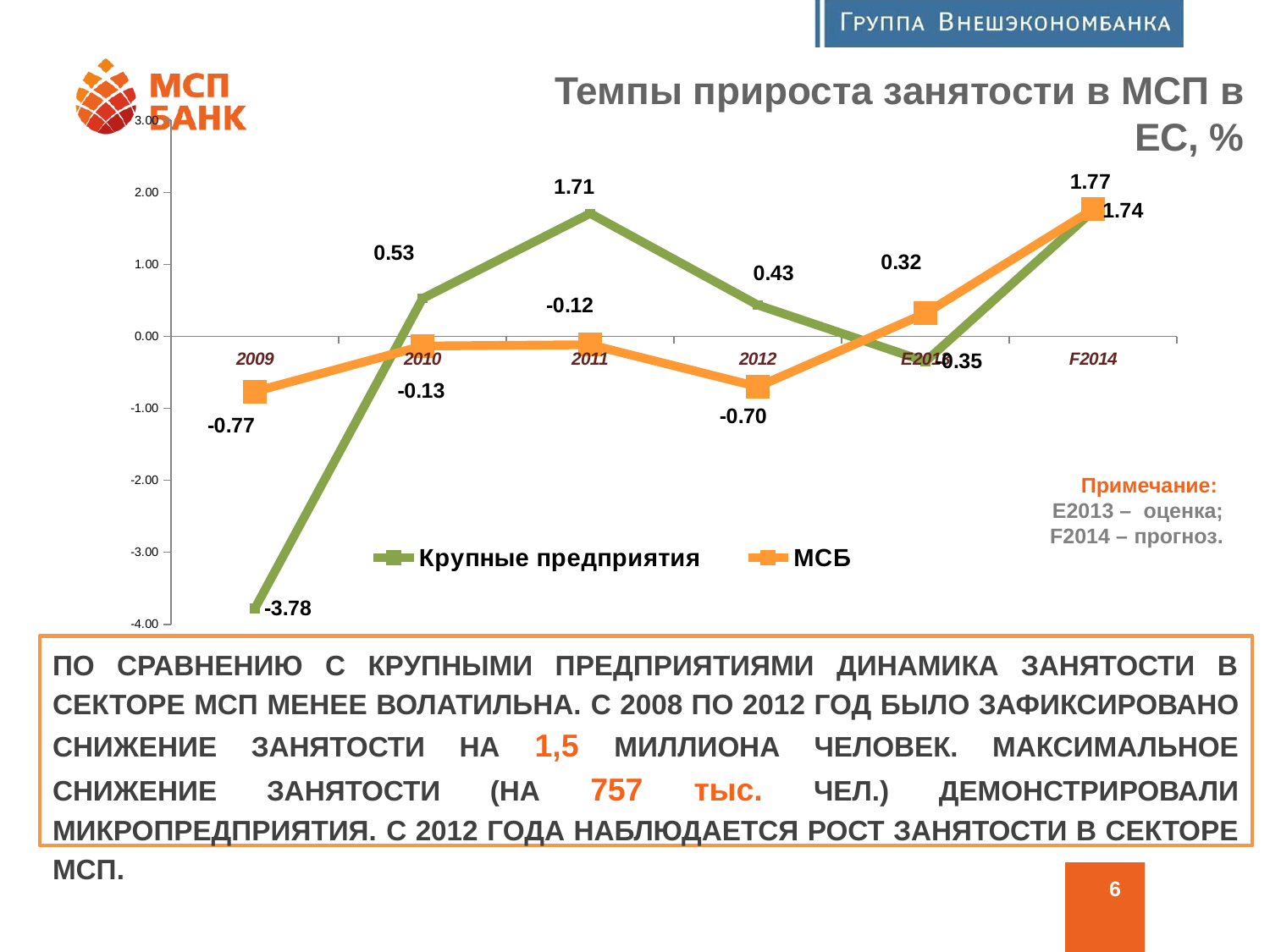
What is the value for МСБ in E2013? 0.32 What kind of chart is shown on the slide? line chart In which year is the value for Крупные предприятия lowest? 2009 What is the value for Крупные предприятия in 2011? 1.71 Is the value for МСБ in F2014 greater or less than 1.00? greater What is the value for Крупные предприятия in 2009? -3.78 What is the difference between the Крупные предприятия value in 2011 and its value in 2012? 1.28 What is the value for МСБ in 2012? -0.70 How many time points are plotted along the x axis? 6 Which series has the larger value in 2010, Крупные предприятия or МСБ? Крупные предприятия How many series does the legend list? 2 In which year is the value for МСБ lowest? 2009